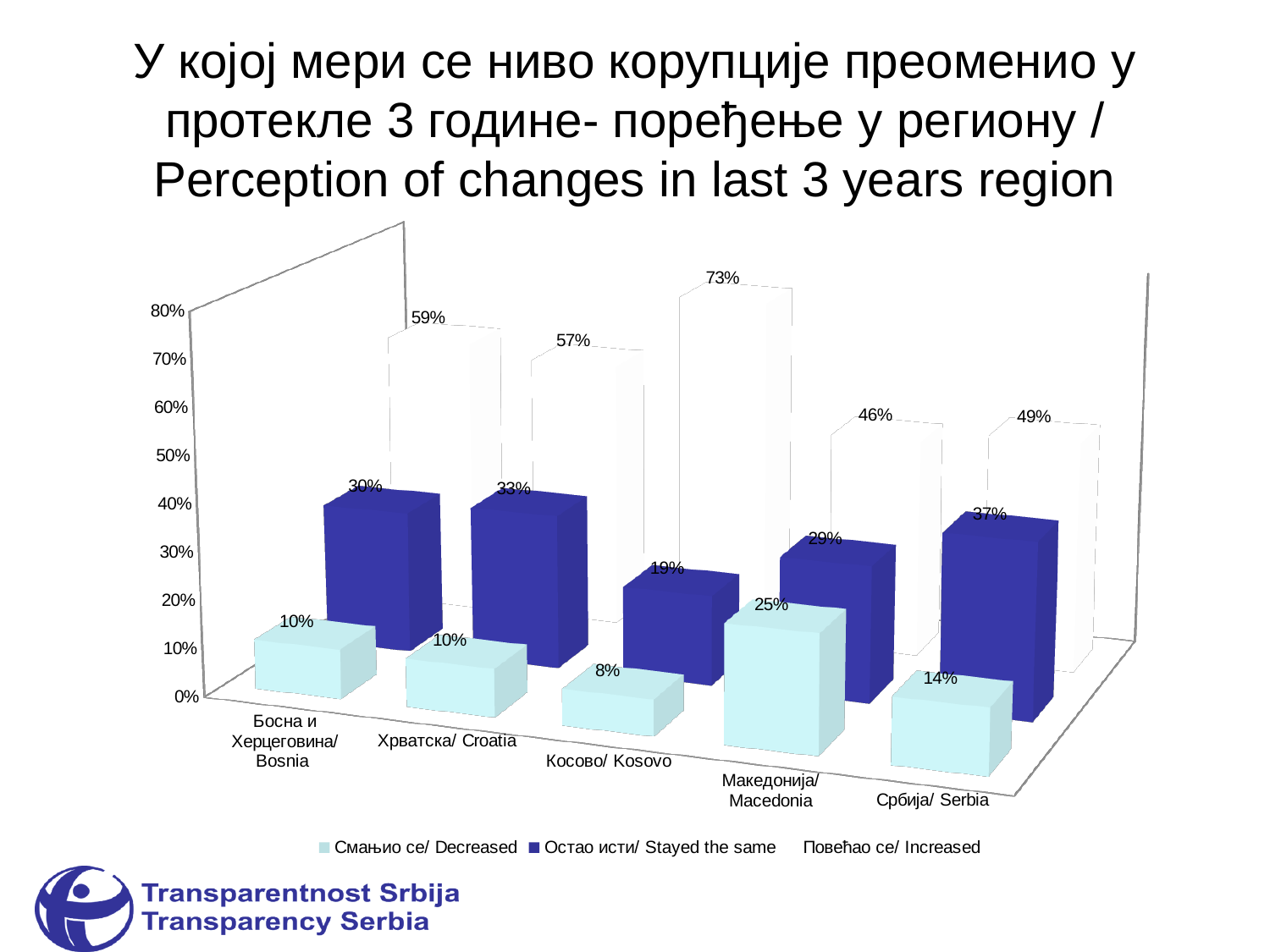
Which is larger: the 'Остао исти/ Stayed the same' value for Хрватска/ Croatia or for Босна и Херцеговина/ Bosnia? Хрватска/ Croatia How many series does the legend list? 3 What is the difference between the 'Повећао се/ Increased' values for Косово/ Kosovo and Македонија/ Macedonia? 27% Which country has the highest value for 'Повећао се/ Increased'? Косово/ Kosovo What is the value for 'Остао исти/ Stayed the same' for Србија/ Serbia? 37% What kind of chart is shown on the slide? bar chart What is the value for 'Повећао се/ Increased' for Косово/ Kosovo? 73% How many countries are shown on the x axis? 5 Which country has the lowest value for 'Смањио се/ Decreased'? Косово/ Kosovo What is the value for 'Смањио се/ Decreased' for Македонија/ Macedonia? 25% What is the total of the three series for Србија/ Serbia? 100% Which series is shown in dark blue in the legend? Остао исти/ Stayed the same